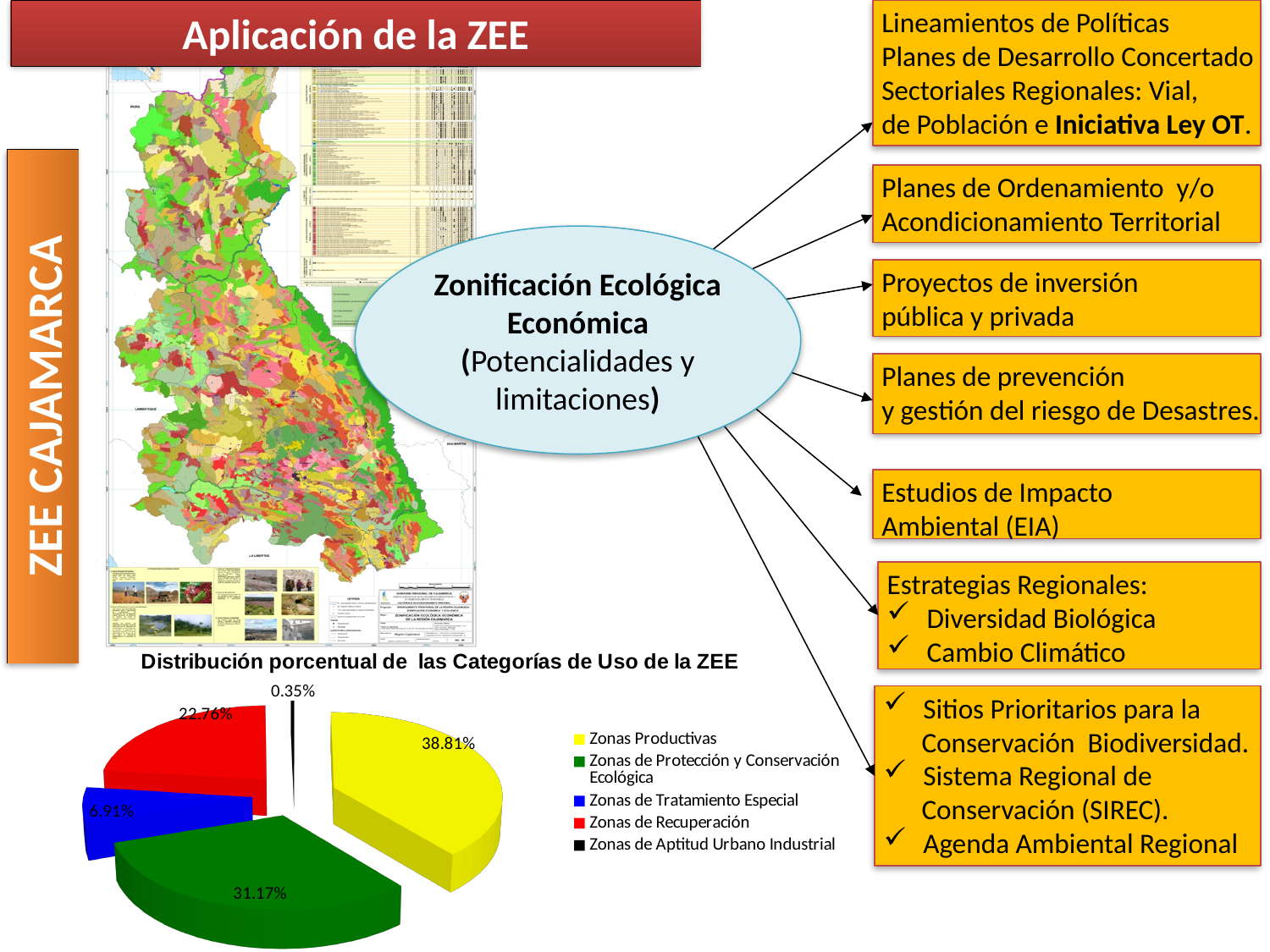
How many categories are shown in the pie chart? 5 What is the difference in percentage points between Zonas Productivas and Zonas de Protección y Conservación Ecológica? 7.64 What is the percentage shown for Zonas de Recuperación? 22.76% What is the percentage shown for Zonas de Protección y Conservación Ecológica? 31.17% What is the percentage shown for Zonas de Tratamiento Especial? 6.91% What is the title of the pie chart? Distribución porcentual de las Categorías de Uso de la ZEE What is the percentage shown for Zonas Productivas in the pie chart? 38.81% What type of chart is used to show the distribution of ZEE use categories? Pie chart Which category has the largest share of the pie chart? Zonas Productivas Which category has the smallest share of the pie chart? Zonas de Aptitud Urbano Industrial Which is larger, the share for Zonas de Recuperación or the share for Zonas de Tratamiento Especial? Zonas de Recuperación What is the percentage shown for Zonas de Aptitud Urbano Industrial? 0.35%